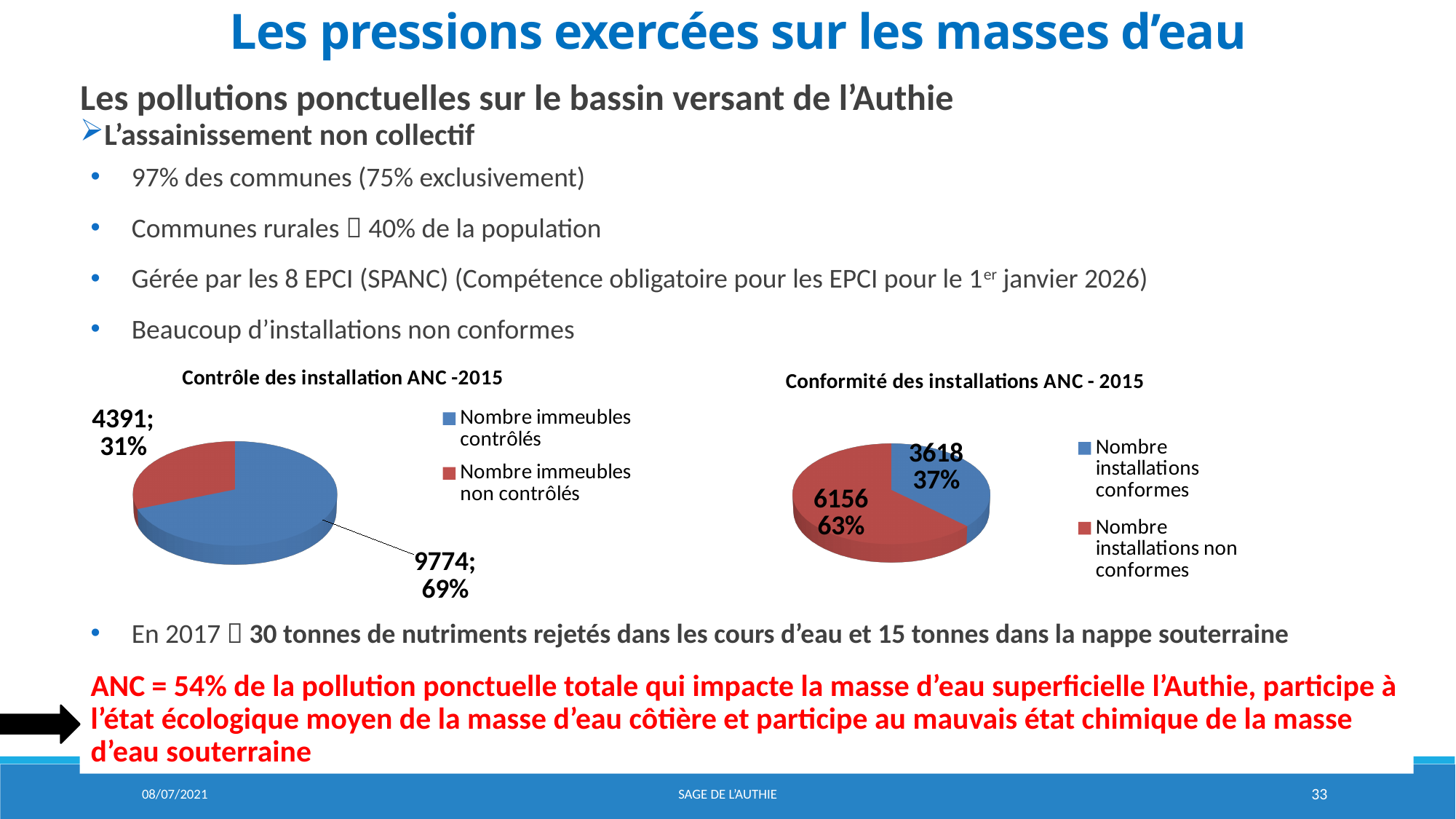
In the chart titled "Conformité des installations ANC - 2015", which category is the smallest? Nombre installations conformes How many entries does the legend of the chart titled "Contrôle des installation ANC -2015" list? 2 What kind of chart is the chart titled "Conformité des installations ANC - 2015"? Pie chart In the chart titled "Contrôle des installation ANC -2015", which category is the largest? Nombre immeubles contrôlés In the chart titled "Contrôle des installation ANC -2015", what is the value for "Nombre immeubles contrôlés"? 9774 In the chart titled "Conformité des installations ANC - 2015", what is the value for "Nombre installations non conformes"? 6156 In the chart titled "Contrôle des installation ANC -2015", what share of the pie is "Nombre immeubles non contrôlés"? 31% In the chart titled "Contrôle des installation ANC -2015", what is the value for "Nombre immeubles non contrôlés"? 4391 In the chart titled "Conformité des installations ANC - 2015", what is the value for "Nombre installations conformes"? 3618 In the chart titled "Conformité des installations ANC - 2015", what share of the pie is "Nombre installations non conformes"? 63% In the chart titled "Contrôle des installation ANC -2015", what is the difference between "Nombre immeubles contrôlés" and "Nombre immeubles non contrôlés"? 5383 In the chart titled "Conformité des installations ANC - 2015", what is the total of the two categories? 9774